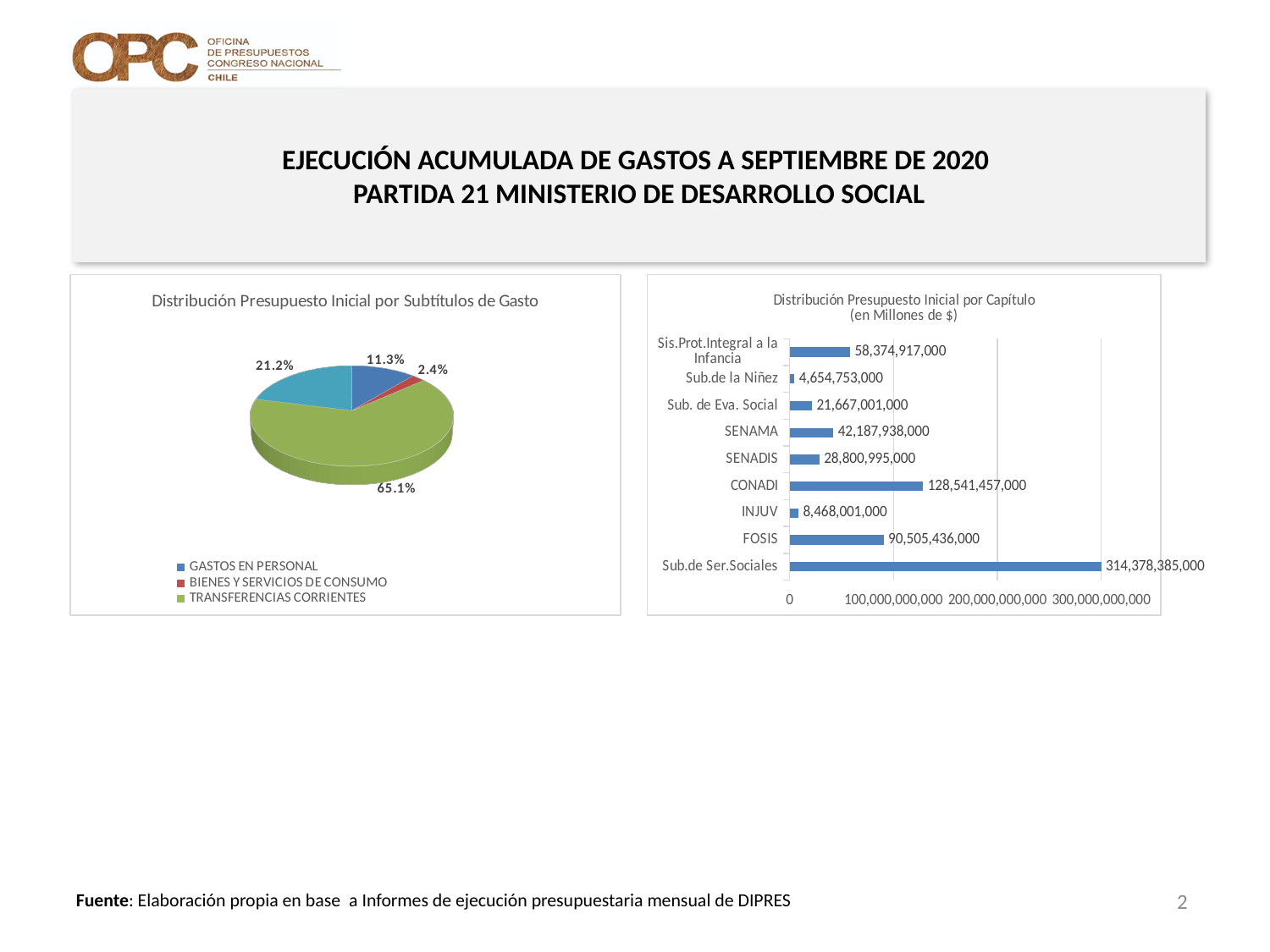
In the bar chart 'Distribución Presupuesto Inicial por Capítulo', what is the value for SENAMA? 42,187,938,000 In the bar chart 'Distribución Presupuesto Inicial por Capítulo', is the value for Sub.de Ser.Sociales greater or less than 300,000,000,000? greater In the bar chart 'Distribución Presupuesto Inicial por Capítulo', what is the difference between the values for FOSIS and INJUV? 82,037,435,000 In the bar chart 'Distribución Presupuesto Inicial por Capítulo', which category has the lowest value? Sub.de la Niñez In the pie chart 'Distribución Presupuesto Inicial por Subtítulos de Gasto', what share does GASTOS EN PERSONAL have? 11.3% In the bar chart 'Distribución Presupuesto Inicial por Capítulo', which category has the highest value? Sub.de Ser.Sociales In the bar chart 'Distribución Presupuesto Inicial por Capítulo', what is the value for CONADI? 128,541,457,000 In the pie chart 'Distribución Presupuesto Inicial por Subtítulos de Gasto', what share does TRANSFERENCIAS CORRIENTES have? 65.1% How many entries does the legend of the pie chart 'Distribución Presupuesto Inicial por Subtítulos de Gasto' list? 3 What kind of chart is 'Distribución Presupuesto Inicial por Capítulo'? Bar chart How many categories are shown in the bar chart 'Distribución Presupuesto Inicial por Capítulo'? 9 In the bar chart 'Distribución Presupuesto Inicial por Capítulo', which is larger, the value for SENADIS or the value for Sub. de Eva. Social? SENADIS